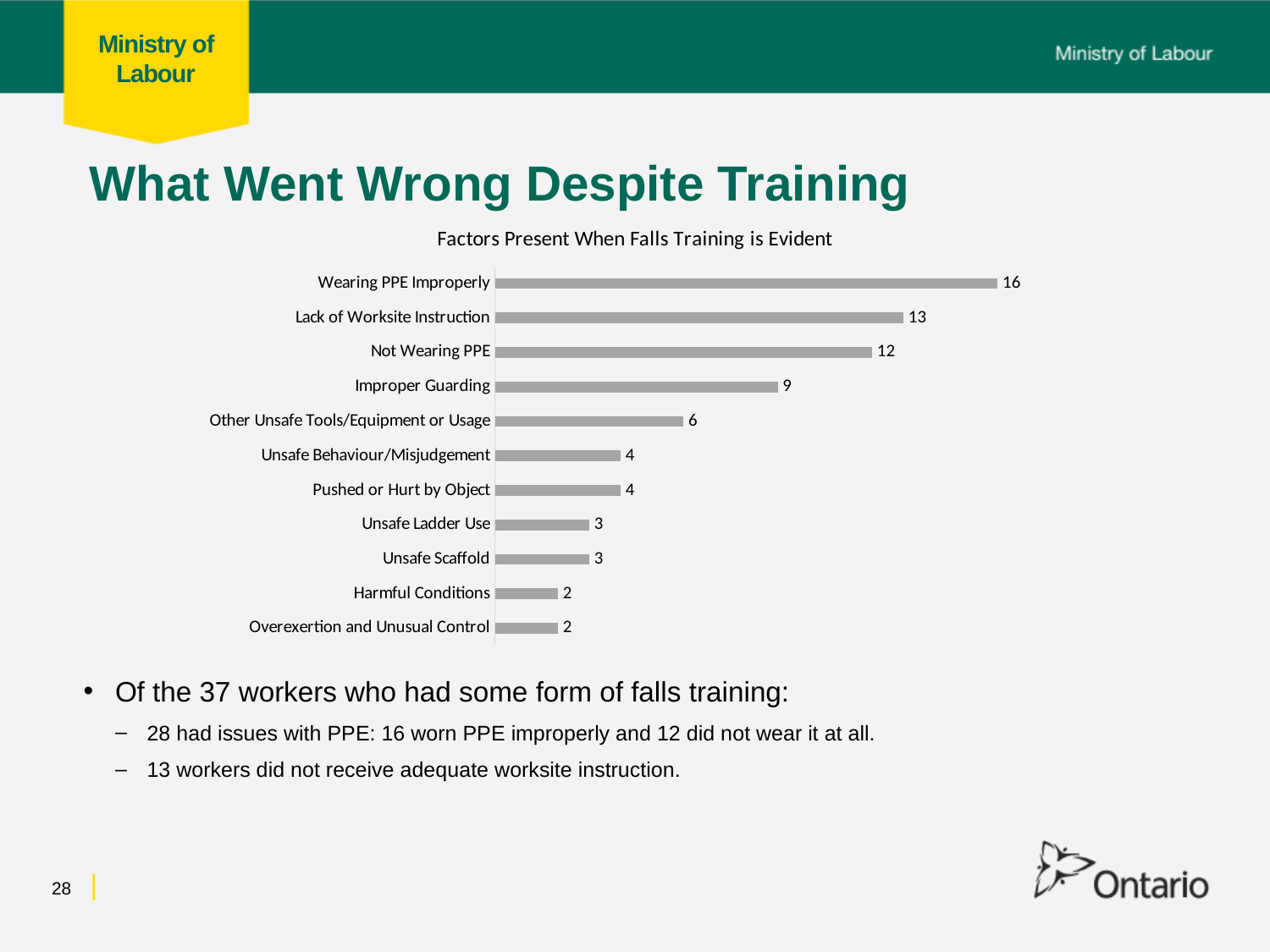
What is the value for Unsafe Ladder Use? 3 What kind of chart is shown on the slide? Bar chart Which is larger, Not Wearing PPE or Other Unsafe Tools/Equipment or Usage? Not Wearing PPE What is the difference between Wearing PPE Improperly and Not Wearing PPE? 4 How many categories are shown in the chart? 11 What is the value for Harmful Conditions? 2 Which category has the highest value? Wearing PPE Improperly What is the value for Improper Guarding? 9 What is the value for Wearing PPE Improperly? 16 What is the title of the chart? Factors Present When Falls Training is Evident What is the value for Lack of Worksite Instruction? 13 What is the difference between Lack of Worksite Instruction and Improper Guarding? 4